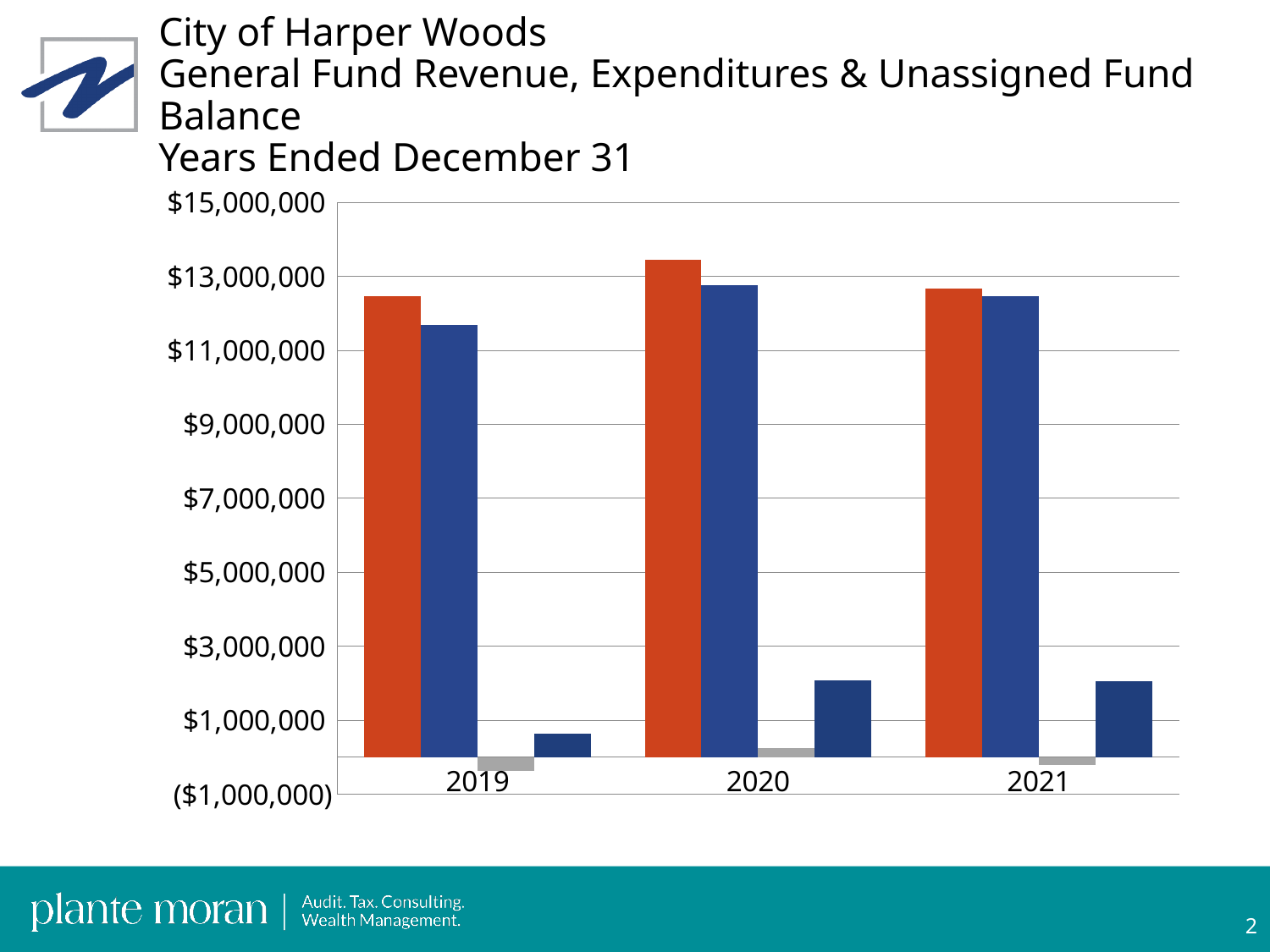
What kind of chart is shown on the slide? Bar chart Is the value of the orange bar for 2020 greater or less than $13,000,000? greater Is the value of the dark blue bar for 2020 greater or less than $1,000,000? greater Is the value of the dark blue bar for 2019 greater or less than $1,000,000? less How many bars are plotted for each year in the chart? 4 How many years are shown on the x axis of the chart? 3 For 2019, which is larger: the orange bar or the blue bar? The orange bar In which year is the dark blue bar the shortest? 2019 What is the highest value labelled on the y axis of the chart? $15,000,000 In which year is the orange bar the tallest? 2020